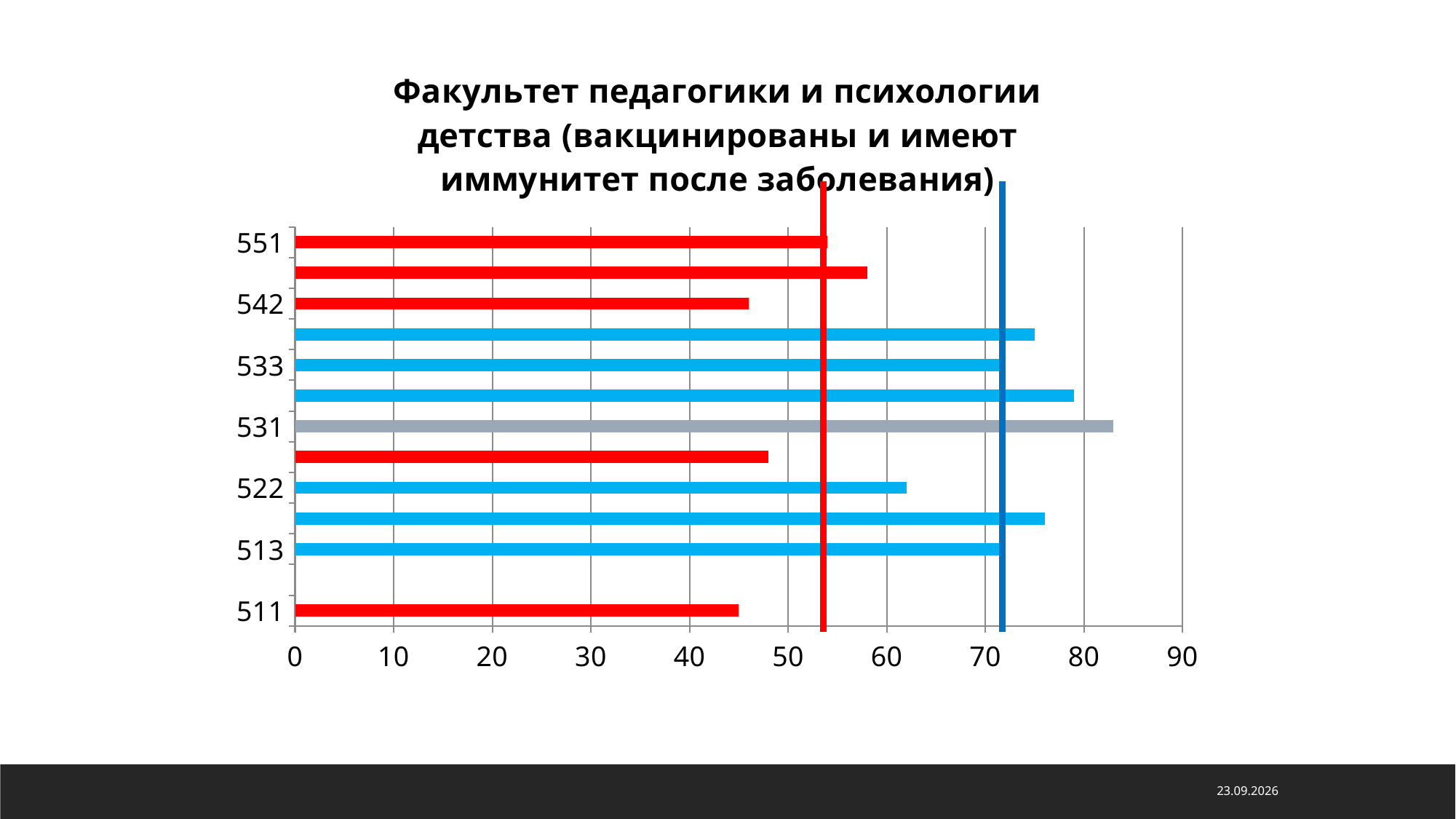
How many category labels are shown on the vertical axis? 7 Which has the larger value, 531 or 511? 531 Is the value for 551 greater or less than 50? greater Which category has the highest value in the chart? 531 Is the value for 522 greater or less than 70? less What colour is the bar for category 531? gray What kind of chart is shown on the slide? bar chart Is the value for 513 greater or less than 60? greater Which has the larger value, 533 or 542? 533